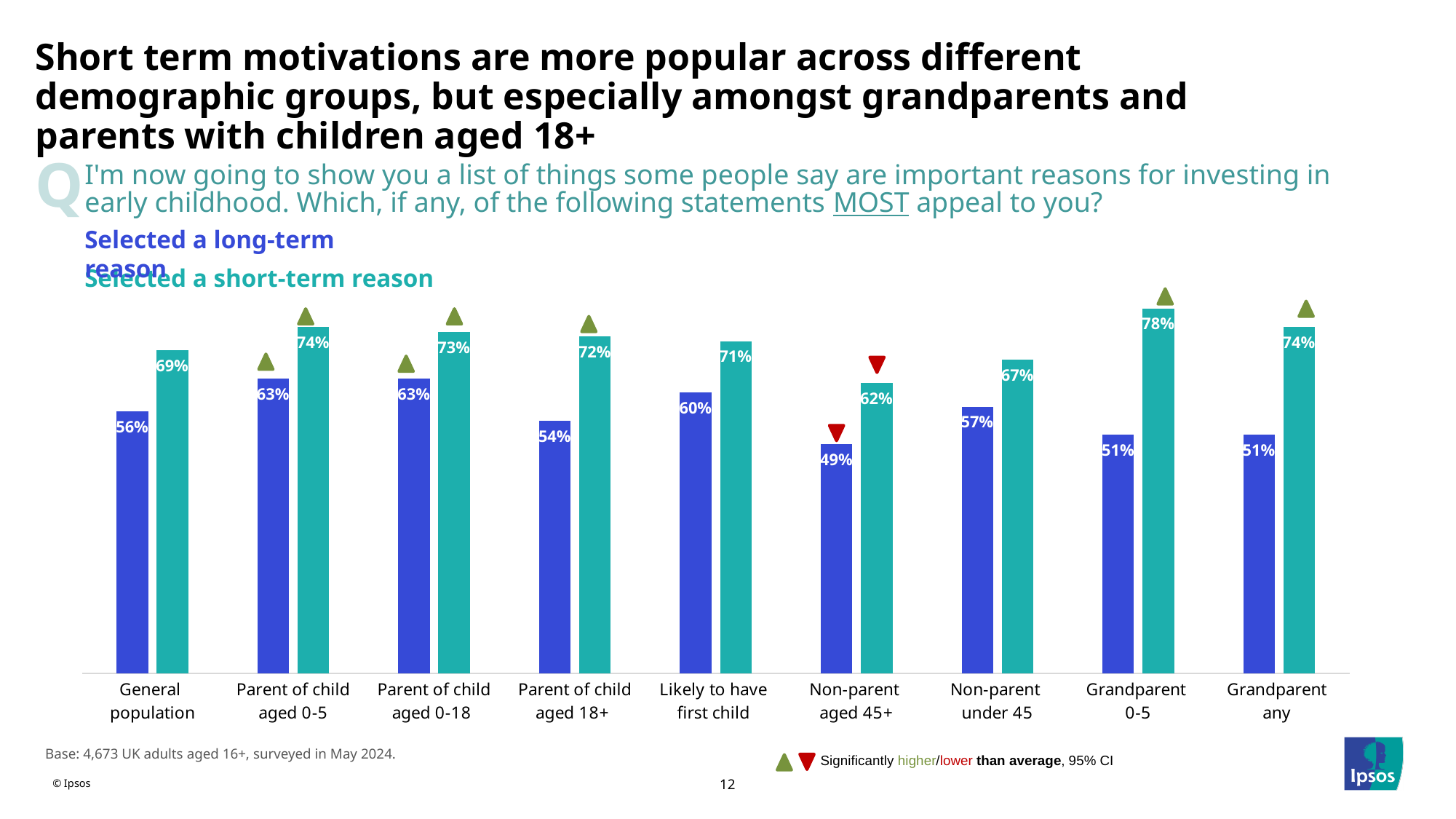
How many demographic groups are shown on the x axis? 9 What is the difference between the short-term and long-term percentages for Parent of child aged 18+? 18 percentage points What type of chart is shown on the slide? Bar chart Which colour represents 'Selected a short-term reason'? Teal Which group has the lowest percentage selecting a long-term reason? Non-parent aged 45+ What percentage of Grandparents 0-5 selected a short-term reason? 78% Which group has the highest percentage selecting a short-term reason? Grandparent 0-5 What percentage of the General population selected a short-term reason? 69% Which is larger for Non-parent under 45: the long-term reason percentage or the short-term reason percentage? Short-term reason What is the difference between the long-term reason percentages for Parent of child aged 0-5 and Grandparent any? 12 percentage points What percentage of Non-parents aged 45+ selected a long-term reason? 49% How many series does the chart show? 2